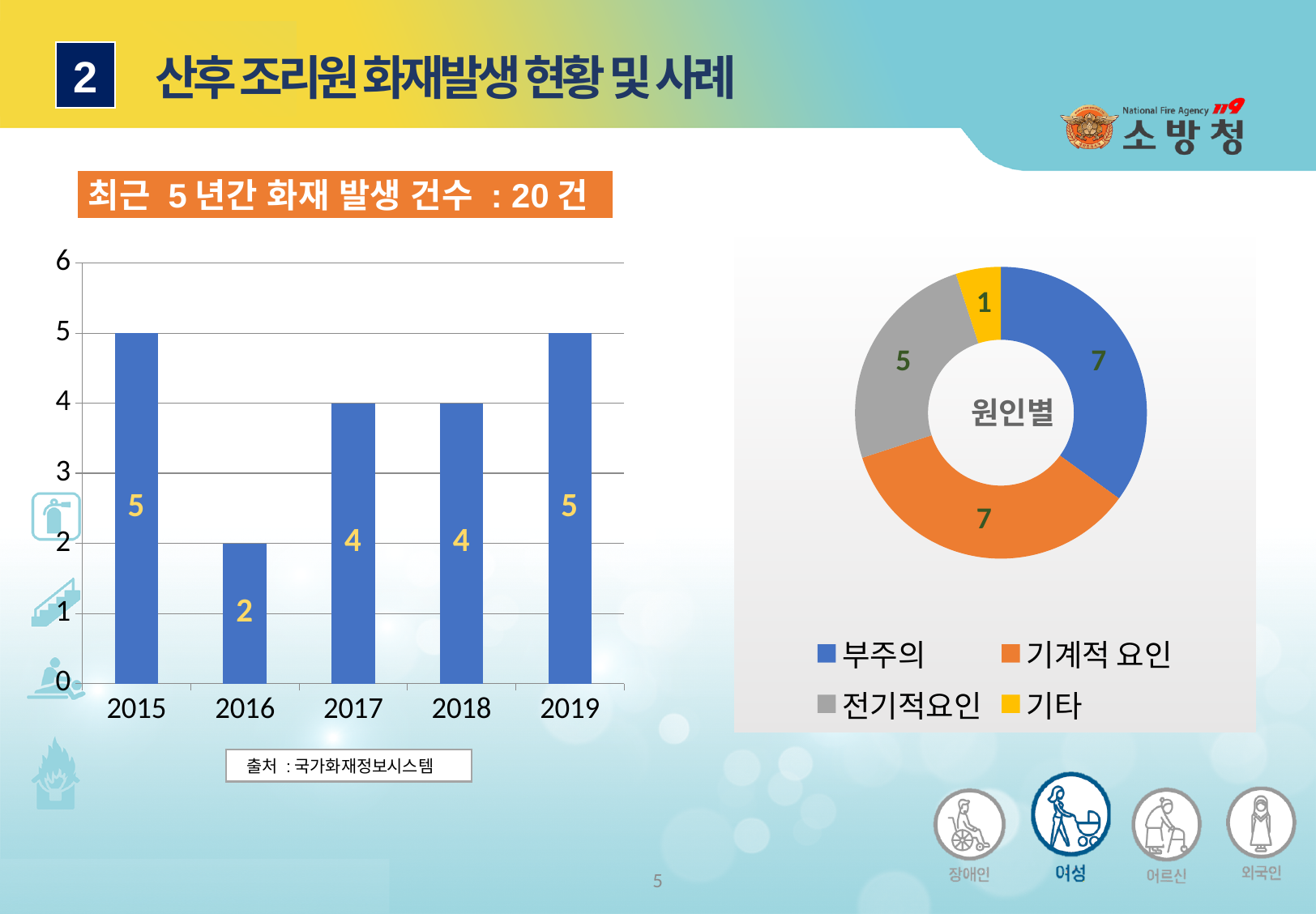
What kind of chart is the chart on the left of the slide? bar chart In the doughnut chart on the right, what share of the total does 부주의 represent? 35% In the bar chart on the left, which year has the lowest value? 2016 In the bar chart on the left, what is the difference between the values for 2015 and 2016? 3 In the doughnut chart on the right, which category has the smallest value? 기타 In the bar chart on the left, which is larger, the value for 2017 or the value for 2019? 2019 In the bar chart on the left, what is the value for 2018? 4 In the doughnut chart on the right, what colour is the 기계적 요인 segment? orange How many categories does the legend of the doughnut chart on the right list? 4 In the doughnut chart on the right, what is the value for 전기적요인? 5 How many years are shown on the x axis of the bar chart on the left? 5 In the bar chart on the left, what is the value for 2016? 2